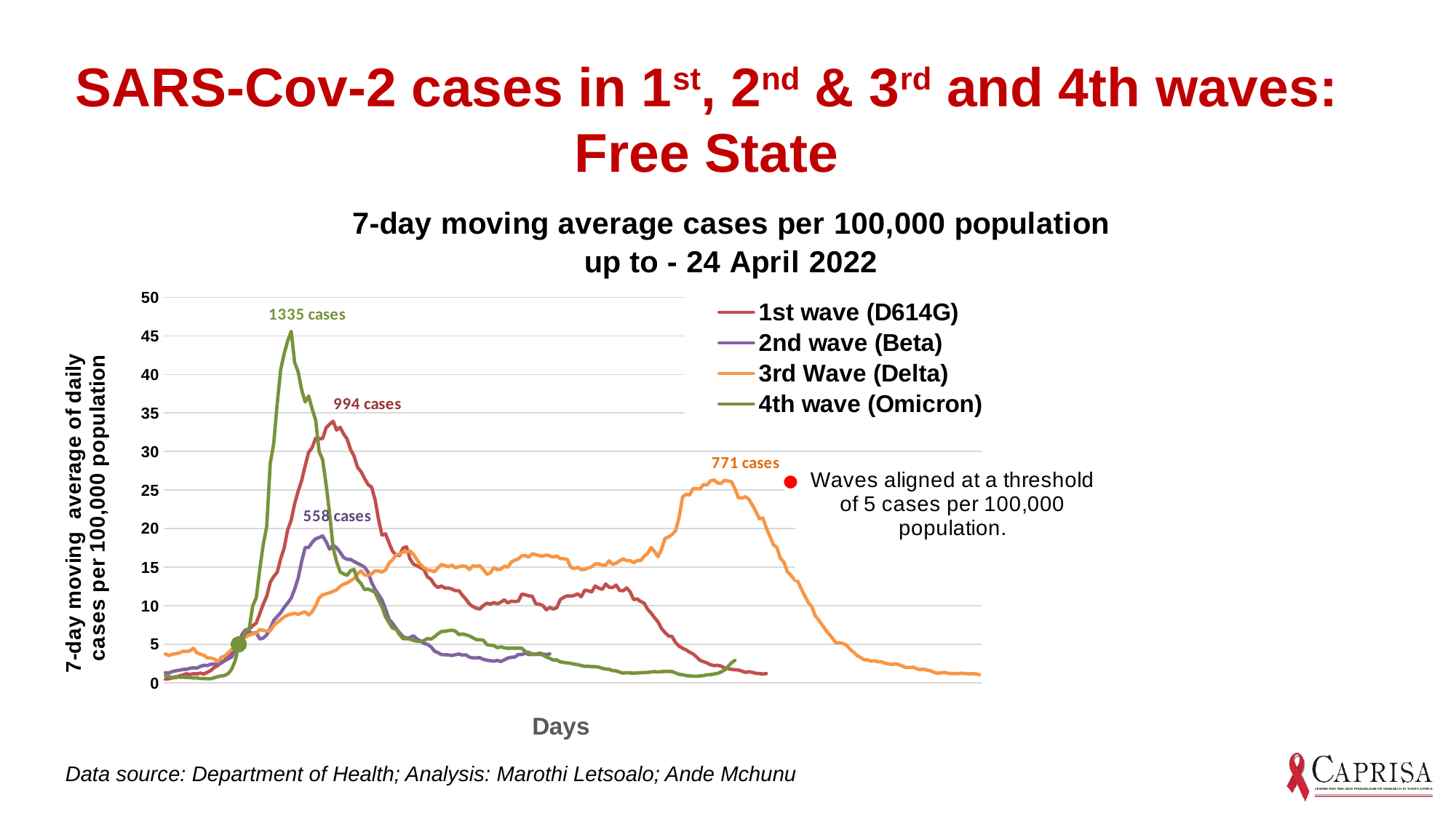
Which wave has the highest labelled peak case count? 4th wave (Omicron) What peak case count is labelled on the 4th wave (Omicron) line? 1335 cases What peak case count is labelled on the 2nd wave (Beta) line? 558 cases How many series does the chart legend list? 4 Which line reaches a higher peak on the chart, the 1st wave (D614G) or the 3rd Wave (Delta)? 1st wave (D614G) What peak case count is labelled on the 3rd Wave (Delta) line? 771 cases What is the difference between the labelled peak case counts of the 4th wave (Omicron) and the 1st wave (D614G)? 341 cases What peak case count is labelled on the 1st wave (D614G) line? 994 cases Is the peak of the 2nd wave (Beta) line greater or less than 20 cases per 100,000 population? less Is the peak of the 4th wave (Omicron) line greater or less than 40 cases per 100,000 population? greater What kind of chart is shown on the slide? line chart Which wave has the lowest labelled peak case count? 2nd wave (Beta)